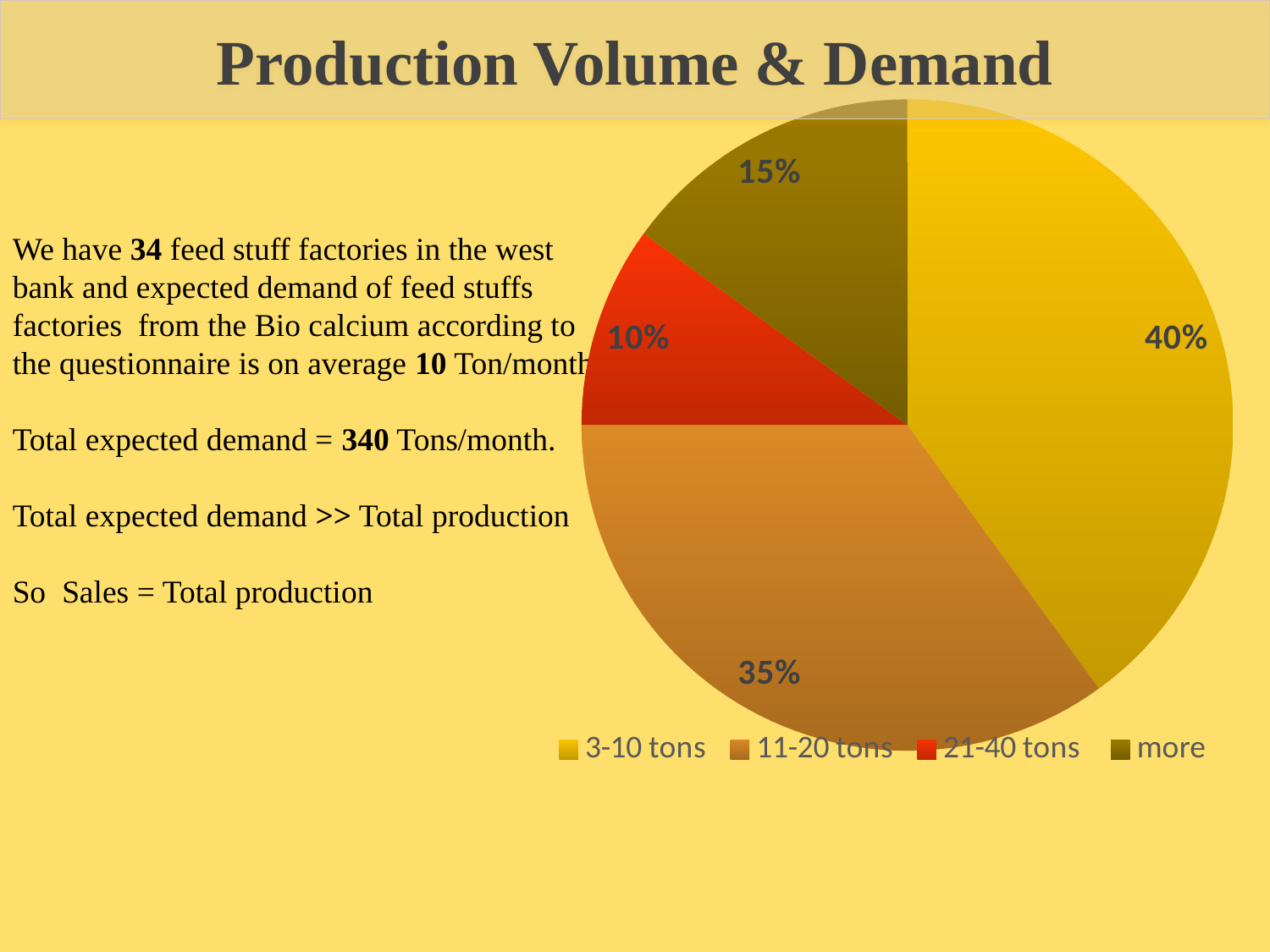
What share of the pie does the 'more' slice represent? 15% Which slice is larger: 'more' or 21-40 tons? more How many categories does the pie chart show? 4 What share of the pie does the 3-10 tons slice represent? 40% What colour is the 21-40 tons slice in the pie chart? red What share of the pie does the 21-40 tons slice represent? 10% What is the difference in percentage points between the 3-10 tons slice and the 11-20 tons slice? 5% What kind of chart is shown on the slide? pie chart Which category has the smallest slice of the pie? 21-40 tons What share of the pie does the 11-20 tons slice represent? 35% What is the combined share of the 21-40 tons and 'more' slices? 25% Which category has the largest slice of the pie? 3-10 tons